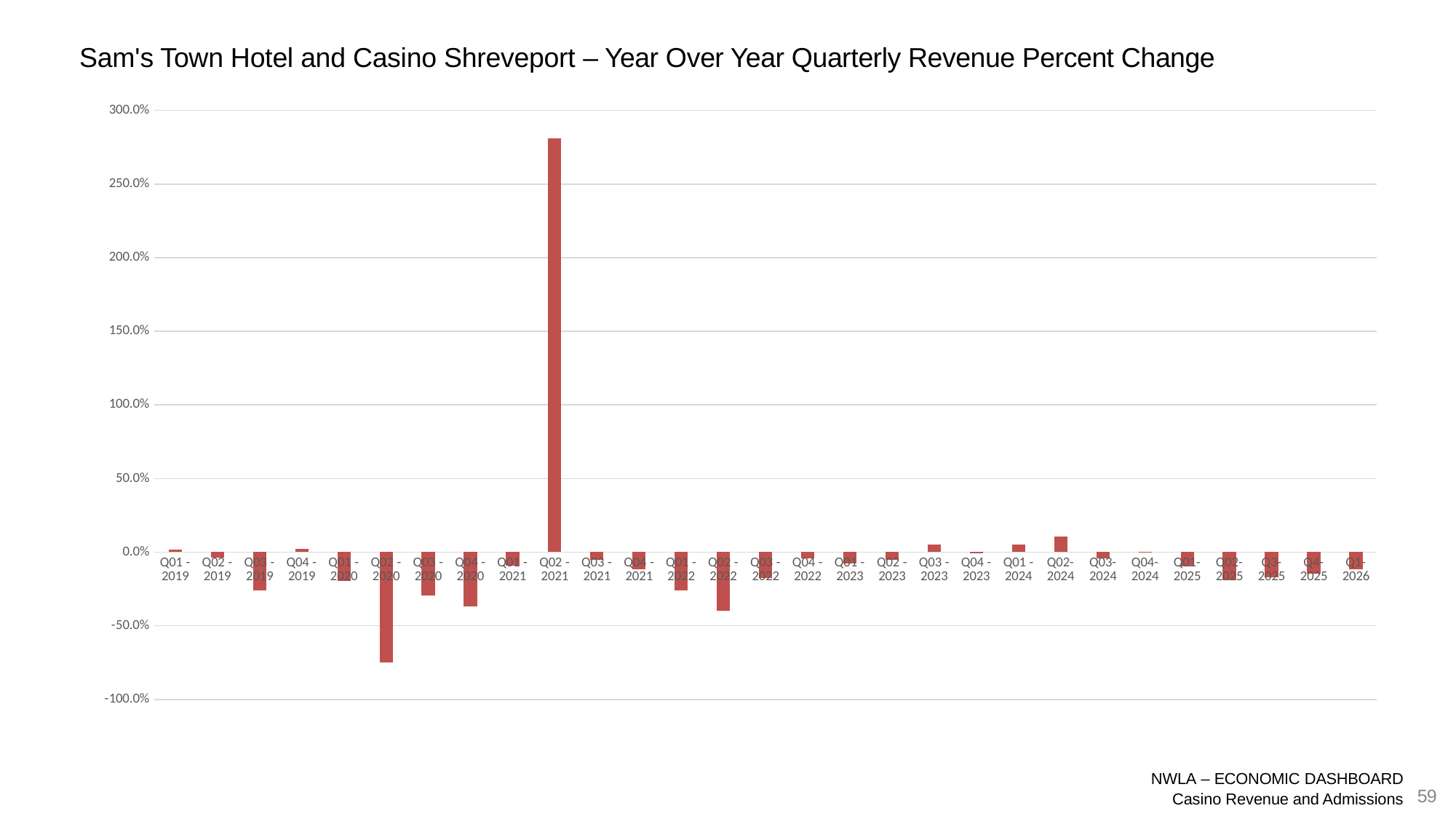
Is the value for Q02 - 2021 greater or less than 250.0%? greater What kind of chart is shown on the slide? bar chart Which is larger, the value for Q02 - 2021 or the value for Q02- 2024? Q02 - 2021 Is the value for Q02 - 2022 greater or less than 0.0%? less Is the value for Q02- 2024 greater or less than 0.0%? greater Which quarter has the lowest year-over-year revenue percent change? Q02 - 2020 What is the title of the chart? Sam's Town Hotel and Casino Shreveport – Year Over Year Quarterly Revenue Percent Change Which is larger, the value for Q03 - 2020 or the value for Q02 - 2020? Q03 - 2020 How many quarters are plotted on the x axis? 29 Which quarter has the highest year-over-year revenue percent change? Q02 - 2021 What is the highest value shown on the y axis? 300.0%